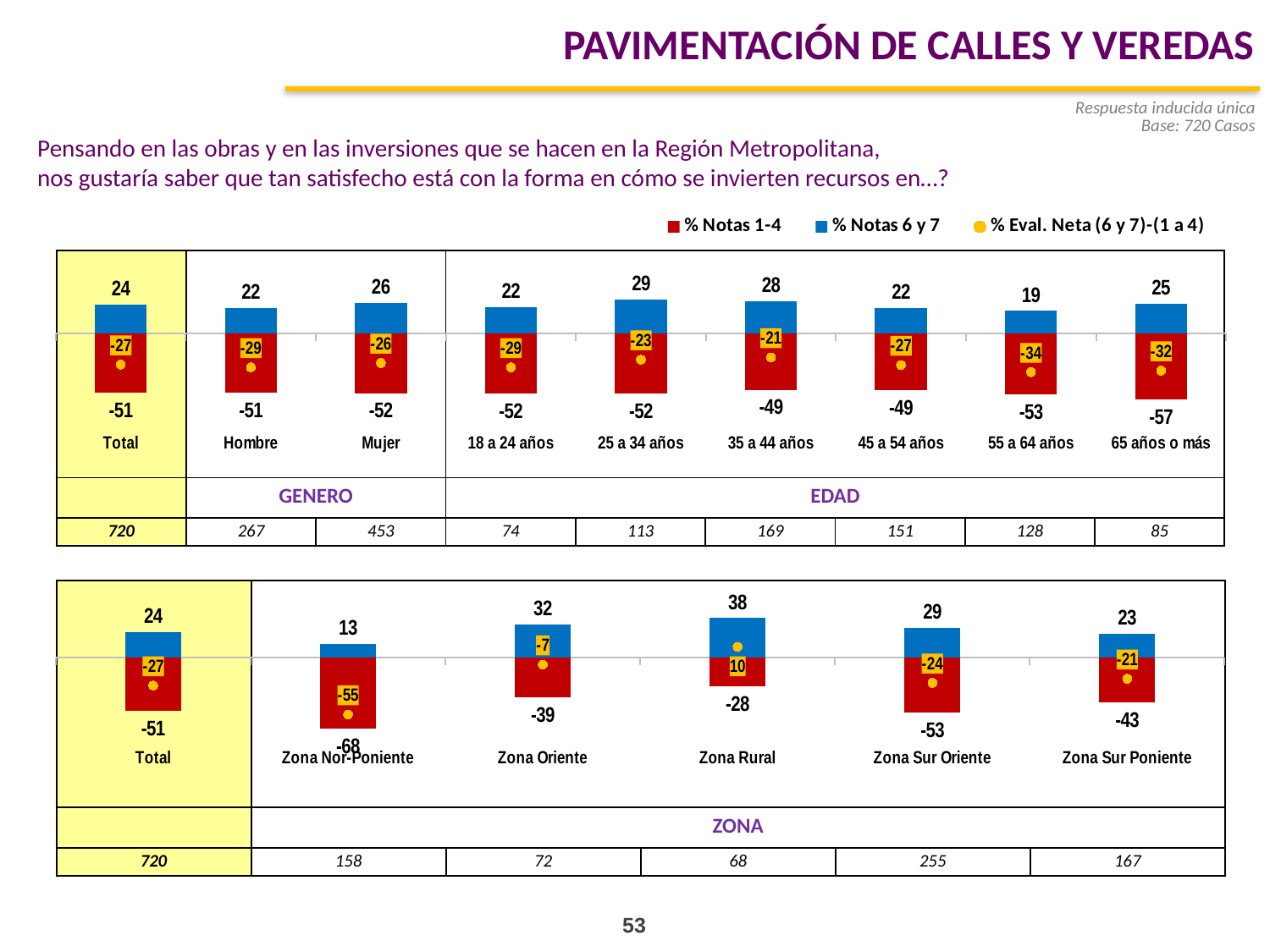
In the top chart, what is the % Notas 6 y 7 value for Mujer? 26 In the bottom chart, which zone has the lowest % Eval. Neta value? Zona Nor-Poniente How many series does the legend list? 3 In the top chart, which age group has the highest % Notas 6 y 7 value? 25 a 34 años In the top chart, what is the difference between the % Notas 6 y 7 values for Mujer and Hombre? 4 In the top chart, which age group has the lowest % Notas 6 y 7 value? 55 a 64 años In the bottom chart, which zone has the highest % Notas 6 y 7 value? Zona Rural In the bottom chart, what is the % Notas 1-4 value for Zona Nor-Poniente? -68 In the bottom chart, which is larger in % Notas 6 y 7: Zona Oriente or Zona Sur Oriente? Zona Oriente How many zones (excluding Total) are shown in the bottom chart? 5 In the top chart, what is the % Eval. Neta value for 55 a 64 años? -34 In the bottom chart, what is the % Eval. Neta value for Zona Rural? 10